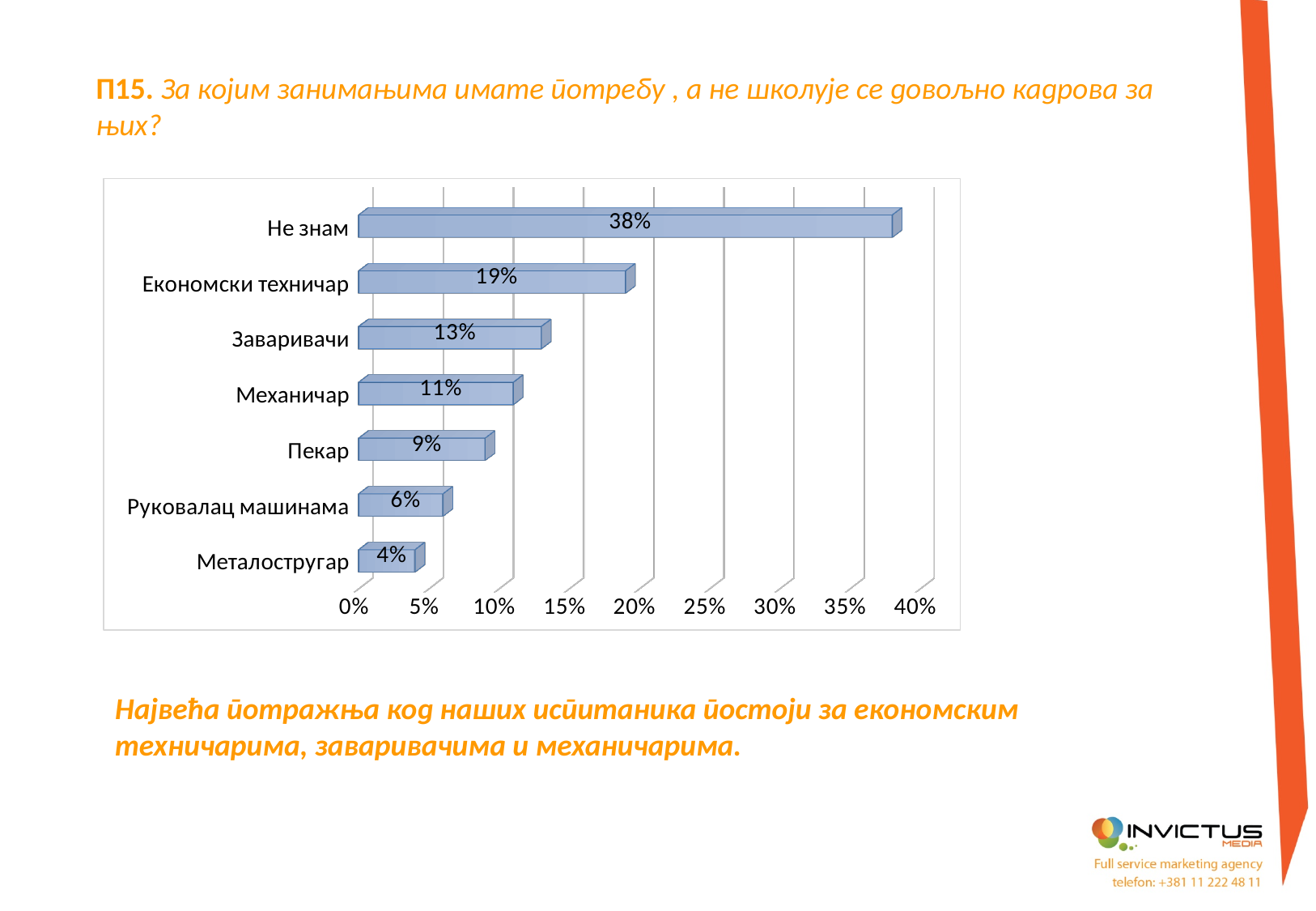
What is the value for Заваривачи? 13% Is the value for Не знам greater or less than 35%? greater Which category has the highest value? Не знам Which is larger, the value for Механичар or the value for Руковалац машинама? Механичар How many categories are shown in the chart? 7 What is the value for Не знам? 38% What is the difference between the values for Економски техничар and Заваривачи? 6% What is the value for Економски техничар? 19% What is the value for Пекар? 9% What is the highest value shown on the horizontal axis? 40% Which category has the lowest value? Металостругар What kind of chart is shown on the slide? bar chart